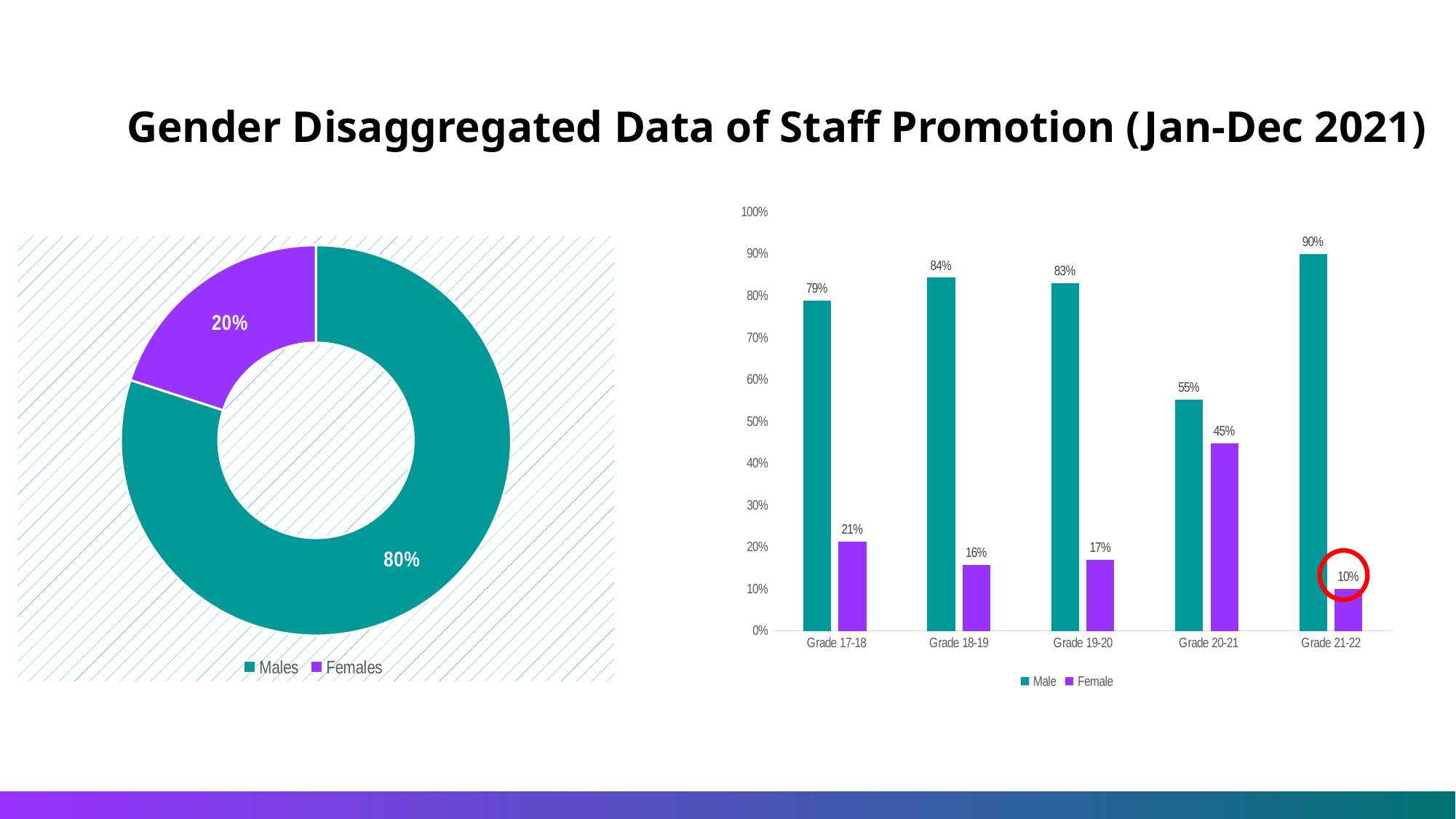
In the bar chart on the right, which grade has the highest Male value? Grade 21-22 In the bar chart on the right, what is the Male value for Grade 18-19? 84% What kind of chart is the chart on the right of the slide? Bar chart How many series does the legend of the bar chart on the right list? 2 What kind of chart is the chart on the left of the slide? Doughnut chart In the doughnut chart on the left, what share of promotions went to Females? 20% In the bar chart on the right, what is the difference between the Male and Female values for Grade 17-18? 58% In the bar chart on the right, is the Female value for Grade 18-19 or Grade 19-20 larger? Grade 19-20 In the doughnut chart on the left, what share of promotions went to Males? 80% In the bar chart on the right, which grade has the lowest Female value? Grade 21-22 How many grade categories are shown in the bar chart on the right? 5 In the bar chart on the right, what is the Female value for Grade 20-21? 45%